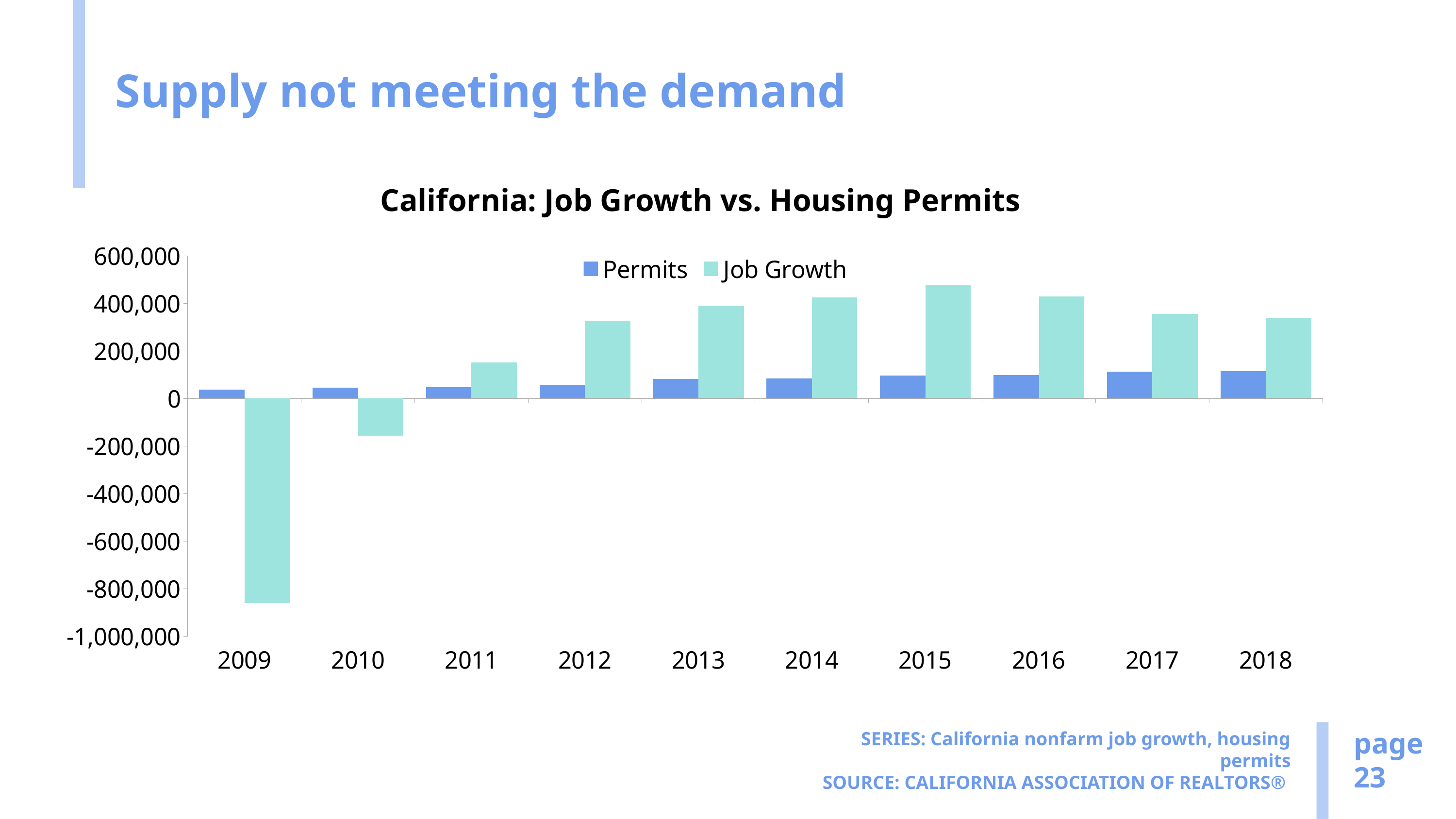
How many series does the legend list? 2 Is the Job Growth value for 2015 greater or less than 400,000? greater Is the Permits value for 2018 greater or less than 200,000? less Is the Job Growth value for 2011 greater or less than 200,000? less How many years are shown on the x axis? 10 What kind of chart is shown on the slide? Bar chart Which is larger in 2018, Permits or Job Growth? Job Growth Which year has the lowest Job Growth value? 2009 Do the Permits values generally rise or fall from 2009 to 2018? Rise What is the title of the chart? California: Job Growth vs. Housing Permits Which year has the highest Job Growth value? 2015